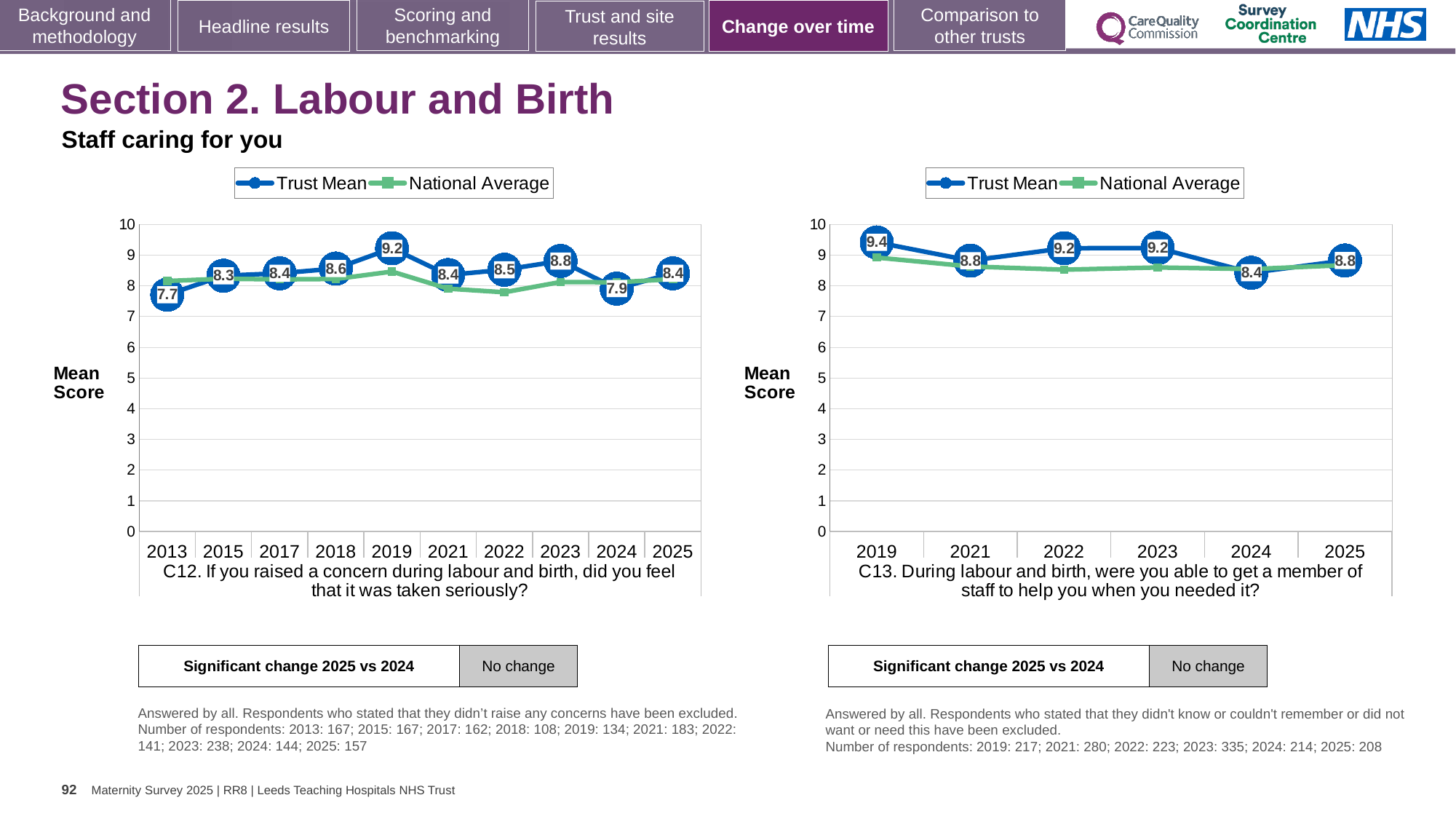
In the C12 chart, which year has the lowest Trust Mean? 2013 In the C12 chart, is the National Average for 2022 greater or less than 8? less In the C12 chart, what is the Trust Mean for 2019? 9.2 In the C12 chart, how many years are shown on the x axis? 10 In the C13 chart, which year has the highest Trust Mean? 2019 In the C13 chart, is the Trust Mean higher in 2019 or in 2025? 2019 In the C12 chart, what is the difference between the Trust Mean for 2023 and 2024? 0.9 In the C12 chart, which year has the highest Trust Mean? 2019 In the C12 chart, what is the Trust Mean for 2013? 7.7 What type of chart is the C13 chart? Line chart In the C13 chart, how many series does the legend list? 2 In the C13 chart, what is the Trust Mean for 2024? 8.4